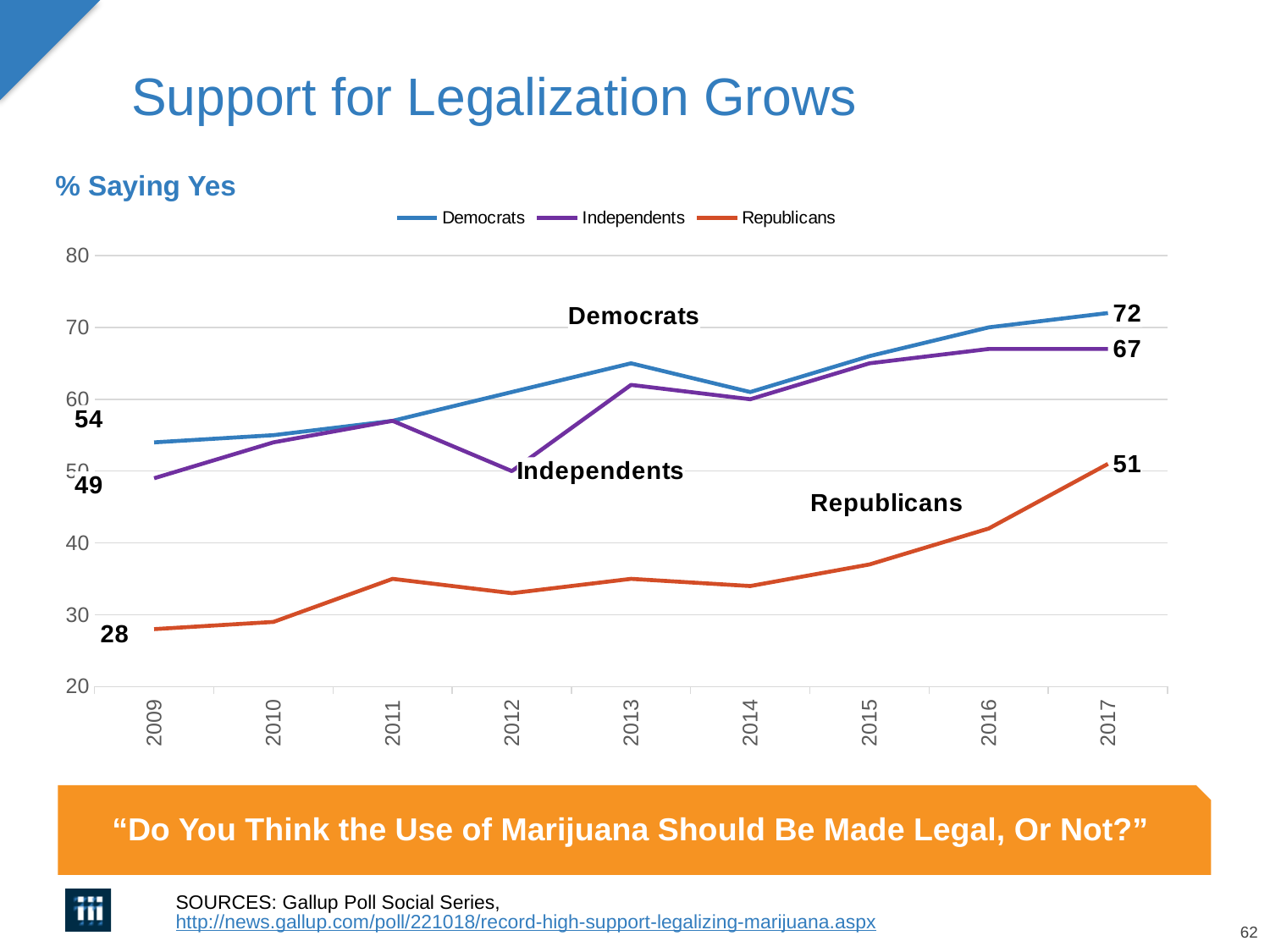
What is the value for Republicans in 2009? 28 What is the difference between the Democrats value in 2017 and in 2009? 18 What is the value for Independents in 2009? 49 What is the value for Democrats in 2017? 72 Which series has the lowest value in 2009? Republicans Which series has the highest value in 2017? Democrats How many years are shown on the x axis? 9 What is the value for Independents in 2017? 67 Is the value for Republicans in 2013 greater or less than 40? less What is the difference between the Democrats and Republicans values in 2017? 21 How many series does the legend list? 3 What kind of chart is shown on the slide? line chart